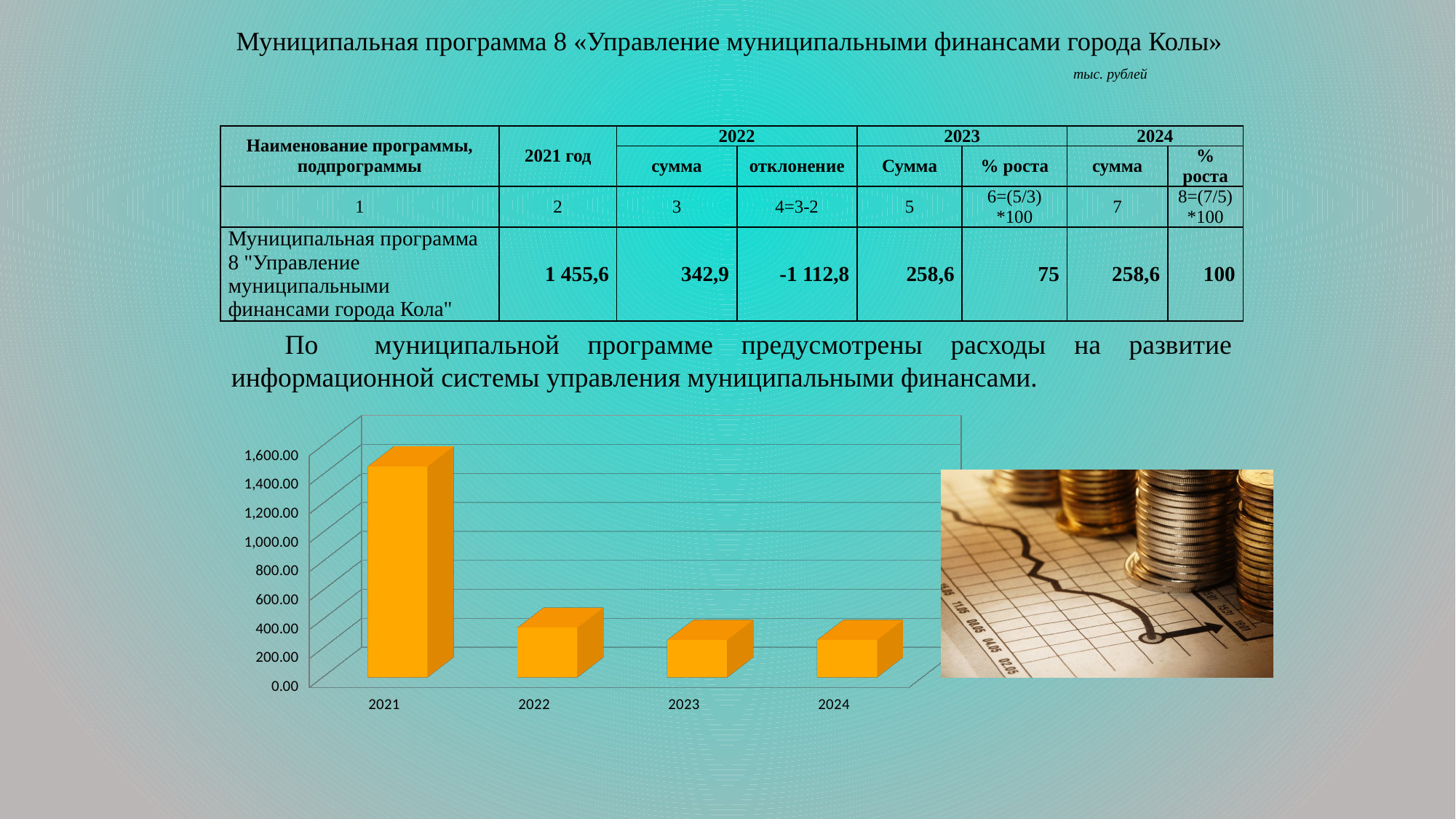
Is the bar for 2024 greater or less than 400.00? less What colour are the bars in the chart? orange Is the bar for 2022 greater or less than 600.00? less Which is larger in the chart, the bar for 2021 or the bar for 2022? 2021 Is the bar for 2023 greater or less than 400.00? less What is the highest value shown on the chart's vertical axis? 1,600.00 Which year has the highest bar in the chart? 2021 How many years are shown on the x axis of the chart? 4 Which is larger in the chart, the bar for 2022 or the bar for 2023? 2022 Do the bar values rise or fall from 2021 to 2023? fall What kind of chart is shown on the slide? bar chart